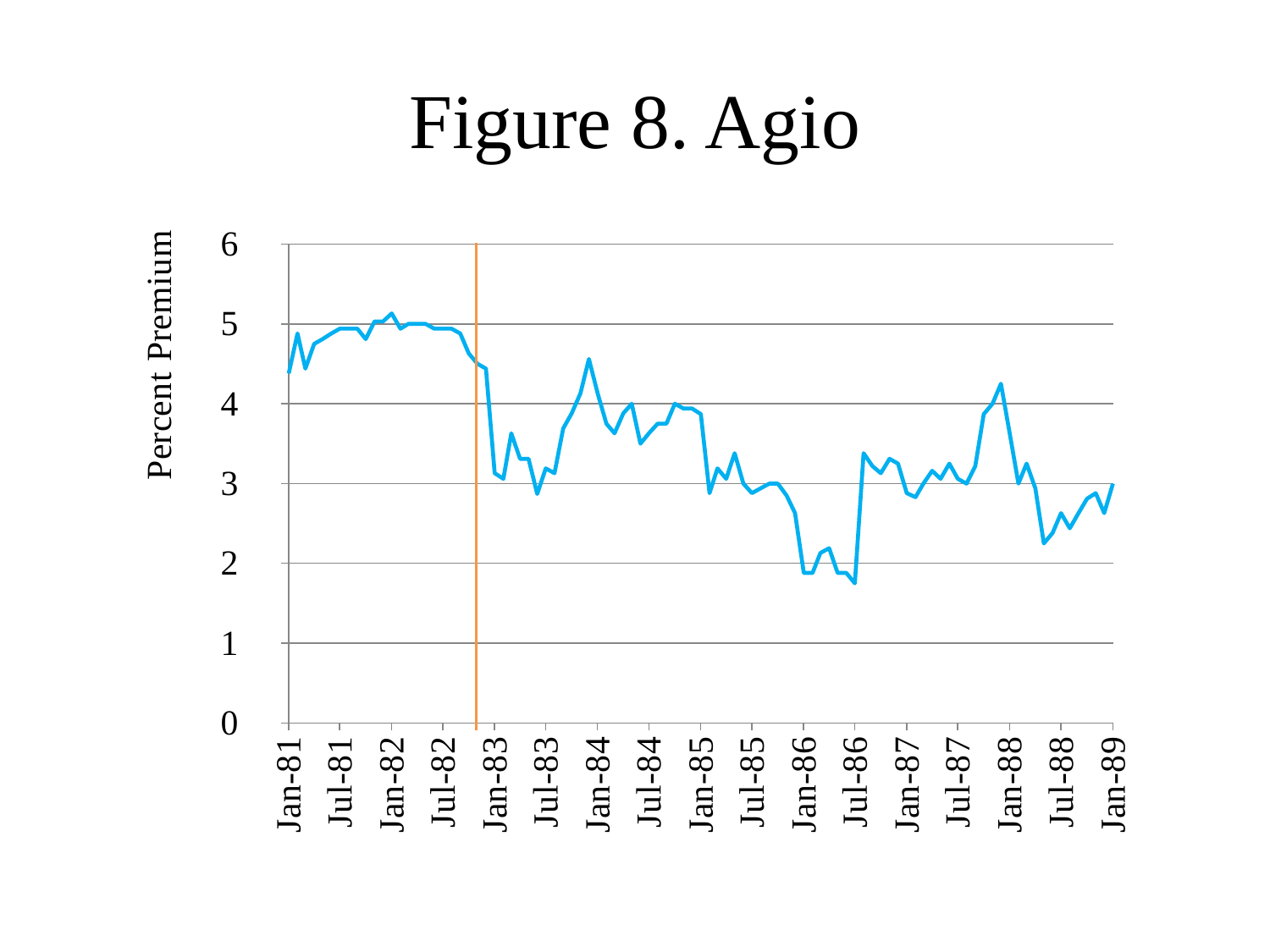
How many date labels are shown along the x axis? 17 Is the value for Jul-88 greater or less than 3? less Is the value for Jan-84 greater or less than 4? greater Which is larger, the value for Jan-82 or the value for Jul-86? Jan-82 What is the label on the vertical axis of the chart? Percent Premium Is the value for Jul-82 greater or less than 4? greater What is the title of the chart? Figure 8. Agio Overall, does the line rise or fall from Jan-81 to Jan-89? fall What kind of chart is shown on the slide? line chart